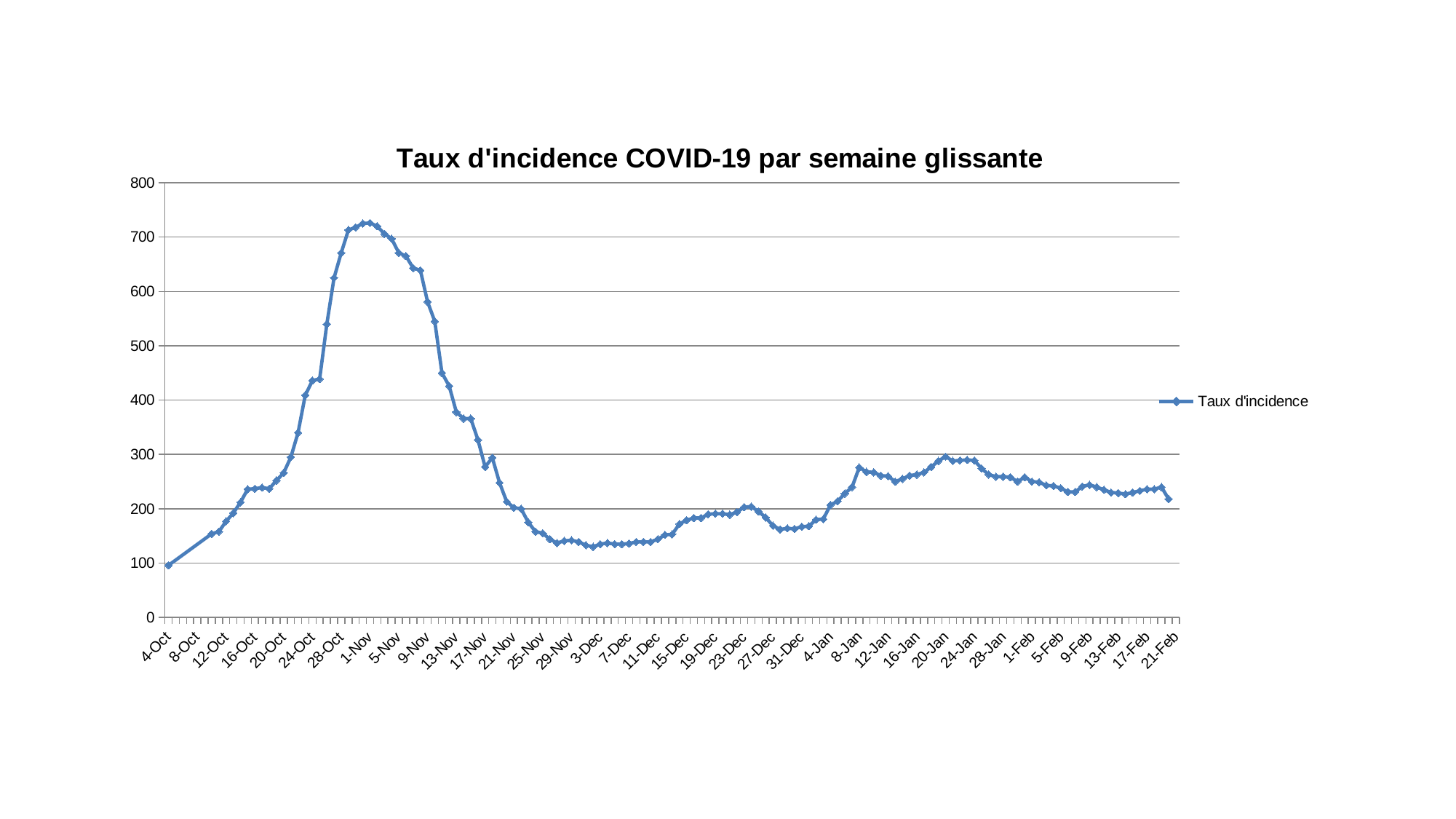
Is the value for 3-Dec greater or less than 200? less Around which date does the incidence rate reach its highest value? 1-Nov What kind of chart is shown on the slide? line chart What is the name of the series shown in the legend? Taux d'incidence Which is larger, the value for 1-Nov or the value for 21-Feb? 1-Nov Is the value for 21-Feb greater or less than 300? less Is the value for 24-Oct greater or less than 300? greater What is the title of the chart? Taux d'incidence COVID-19 par semaine glissante How many series does the legend list? 1 Does the incidence rate rise or fall between 4-Oct and 1-Nov? rise On which date is the incidence rate at its lowest? 4-Oct